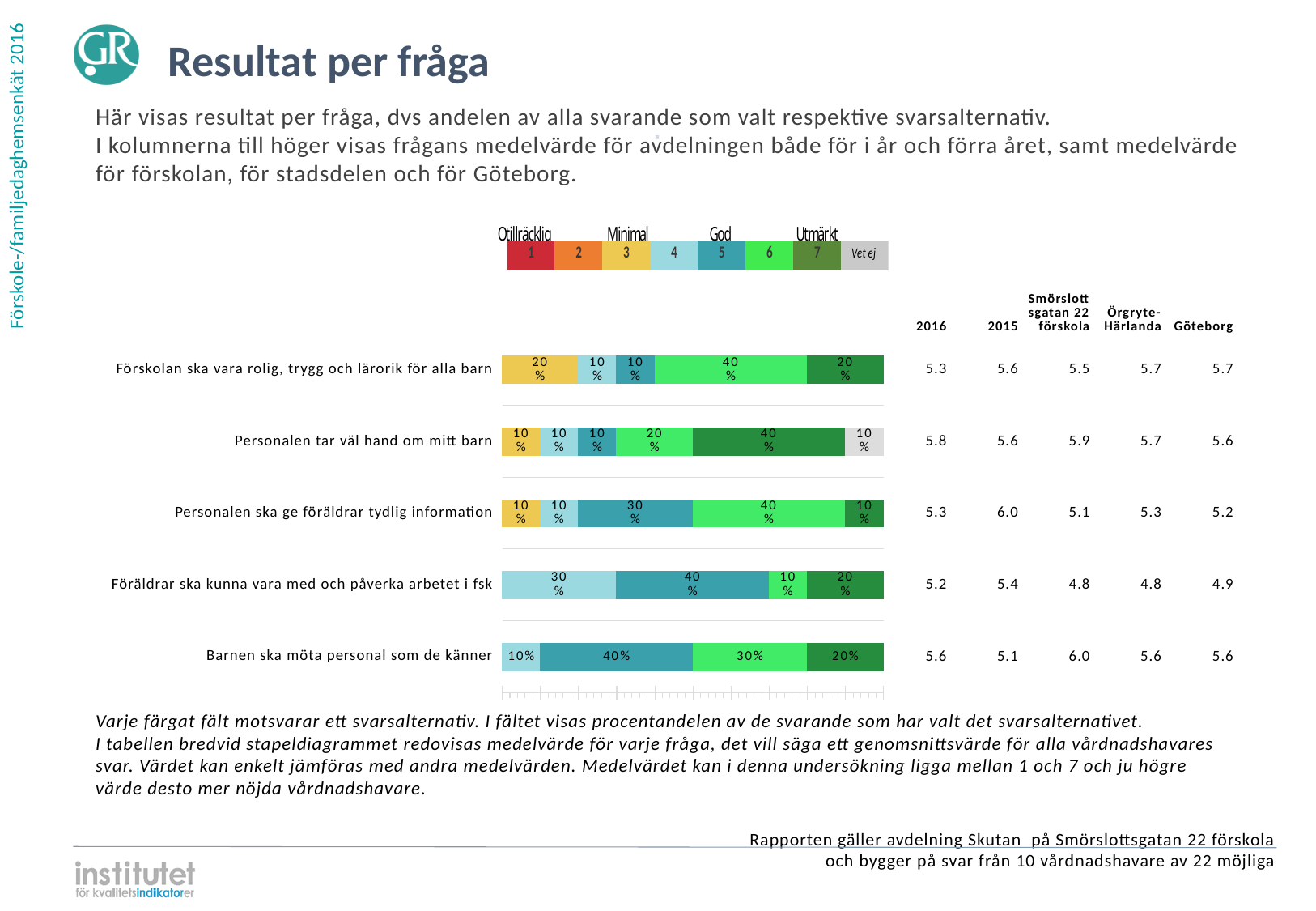
What is the 2016 mean value shown for 'Personalen tar väl hand om mitt barn'? 5.8 What percentage of respondents answered 'Vet ej' for 'Personalen tar väl hand om mitt barn'? 10% How many answer alternatives does the legend above the chart list? 8 What percentage of respondents chose answer 5 (teal) for 'Personalen ska ge föräldrar tydlig information'? 30% What percentage of respondents chose answer 7 (dark green) for 'Personalen tar väl hand om mitt barn'? 40% Which answer alternative has the largest share for 'Föräldrar ska kunna vara med och påverka arbetet i fsk'? 5 What kind of chart is shown on the slide? Stacked bar chart What percentage of respondents chose answer 6 (bright green) for 'Förskolan ska vara rolig, trygg och lärorik för alla barn'? 40% For 'Förskolan ska vara rolig, trygg och lärorik för alla barn', which is larger: the share for answer 3 or the share for answer 4? Answer 3 What is the total of all segments in the bar for 'Barnen ska möta personal som de känner'? 100% What is the difference between the share for answer 5 and the share for answer 6 in 'Barnen ska möta personal som de känner'? 10% How many questions (bars) are plotted in the chart? 5